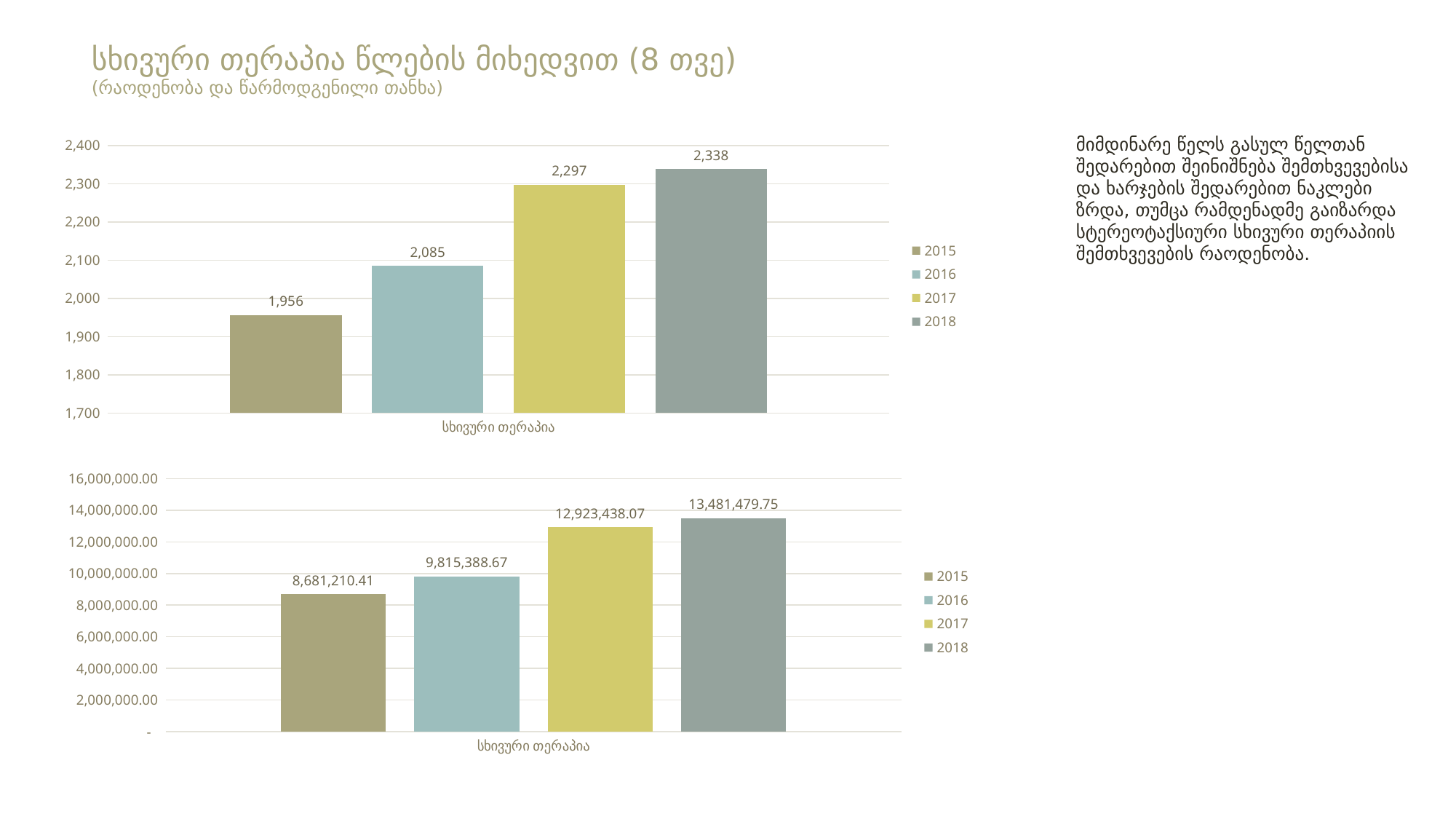
In the top chart, what is the difference between the 2018 and 2015 values? 382 In the bottom chart, what is the value for 2018? 13,481,479.75 In the top chart, what is the value for 2015? 1,956 In the top chart, which year has the highest value? 2018 In the bottom chart, which year has the lowest value? 2015 In the bottom chart, what is the value for 2016? 9,815,388.67 In the top chart, what is the value for 2017? 2,297 In the bottom chart, is the value for 2017 larger or smaller than the value for 2016? larger What kind of chart is the top chart? bar chart How many series does the legend of the bottom chart list? 4 In the top chart, which year has the lowest value? 2015 In the top chart, do the values rise or fall from 2015 to 2018? rise